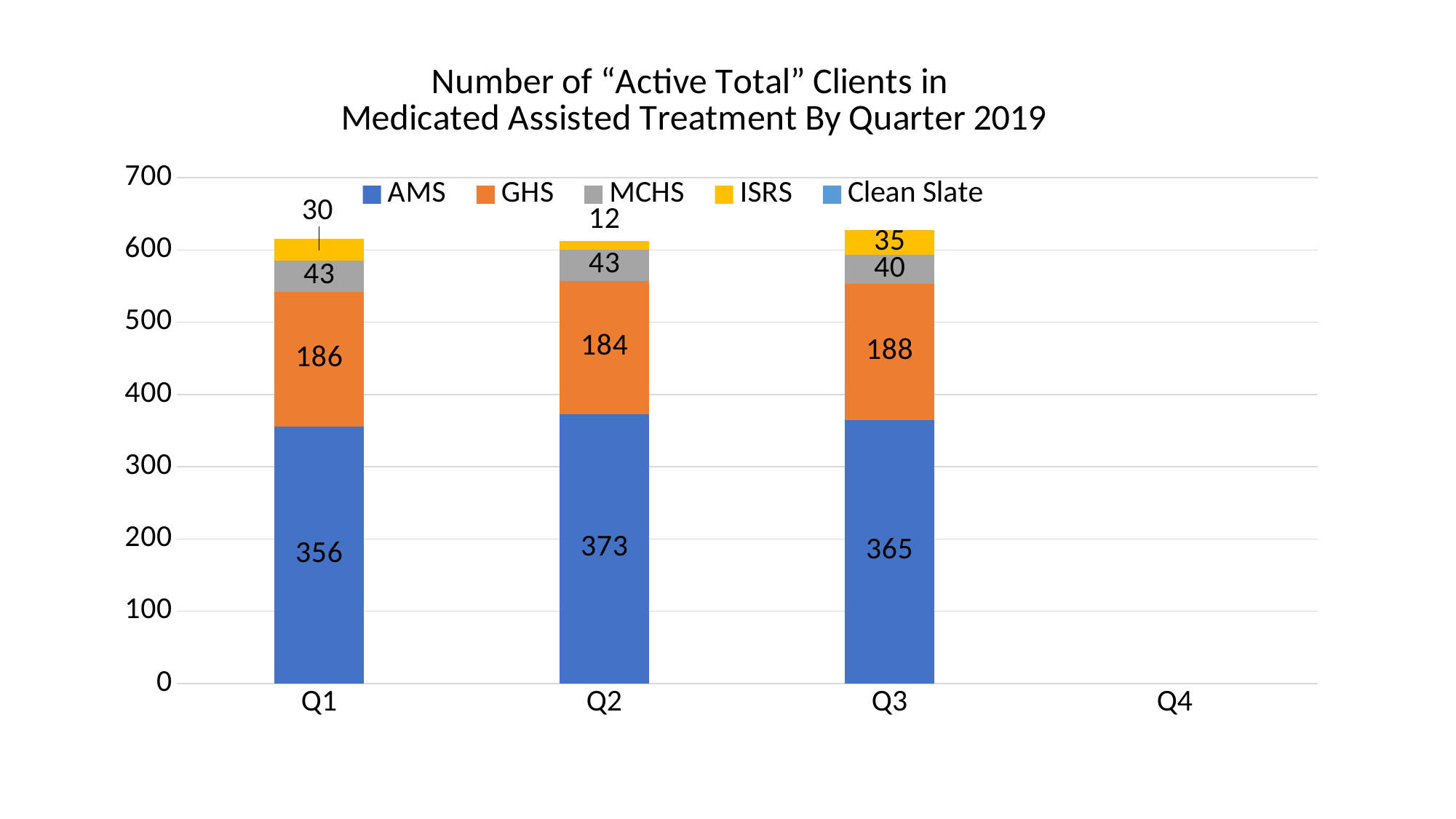
Which quarter has the lowest ISRS value? Q2 What is the MCHS value for Q1? 43 Which is larger, the GHS value for Q1 or for Q3? Q3 What is the AMS value for Q1? 356 What colour represents ISRS in the legend? Yellow What is the GHS value for Q3? 188 What is the difference between the AMS values for Q2 and Q1? 17 How many series does the legend list? 5 Which quarter has the highest AMS value? Q2 What kind of chart is shown on the slide? Stacked bar chart How many quarters are shown on the x axis? 4 What is the ISRS value for Q2? 12